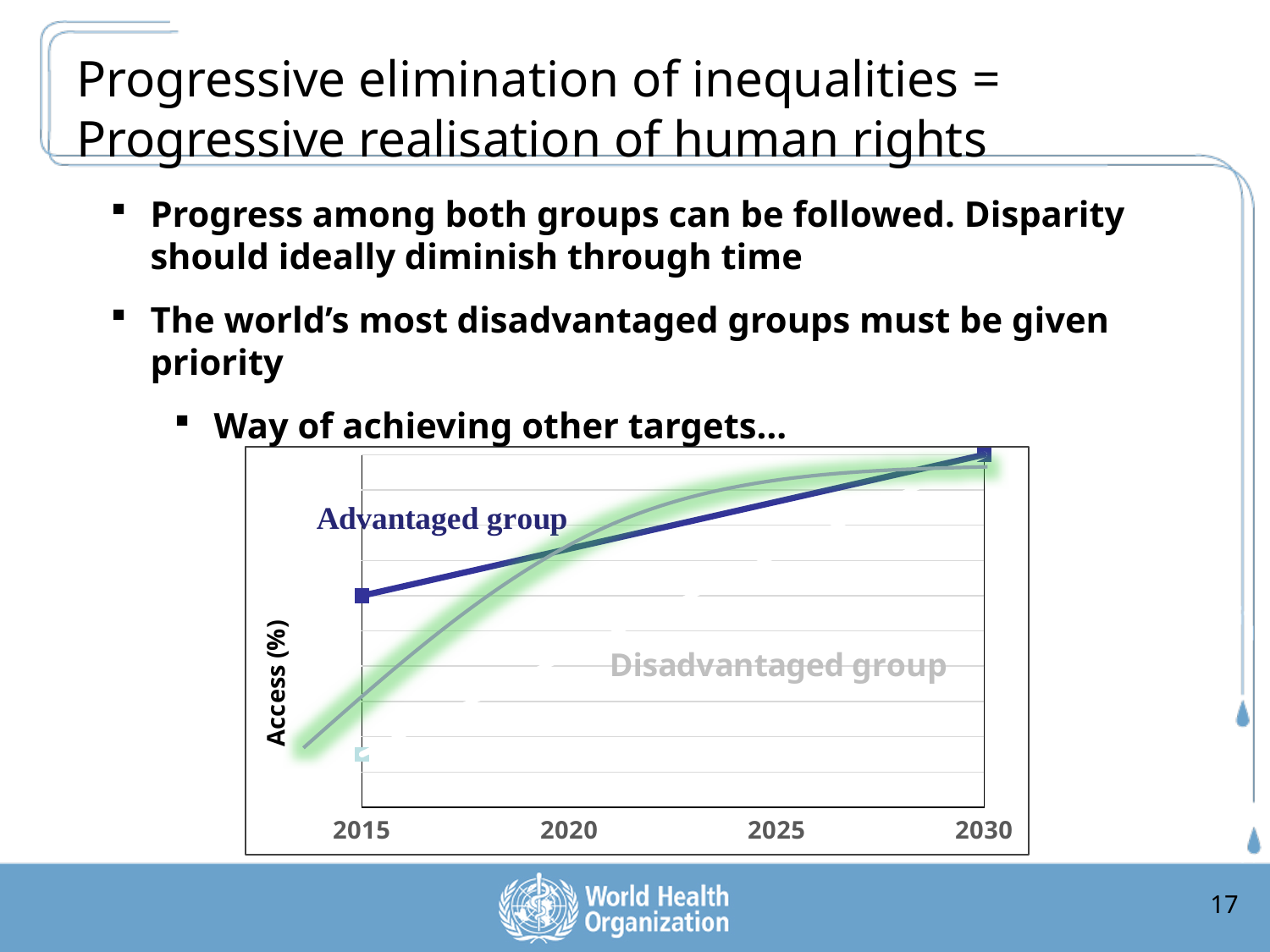
In 2015, which group has the higher access value, the Advantaged group or the Disadvantaged group? Advantaged group How many series are plotted on the chart? 2 What is the first year shown on the horizontal axis? 2015 Does the Advantaged group line rise or fall from 2015 to 2030? rise Does the Disadvantaged group line rise or fall from 2015 to 2030? rise What kind of chart is shown on the slide? line chart Which group shows the steeper increase between 2015 and 2020? Disadvantaged group Which group has the lowest access value at the start of the chart in 2015? Disadvantaged group How many year labels are shown on the horizontal axis? 4 What is the last year shown on the horizontal axis? 2030 What are the names of the two groups plotted on the chart? Advantaged group and Disadvantaged group What is the label of the vertical axis? Access (%)